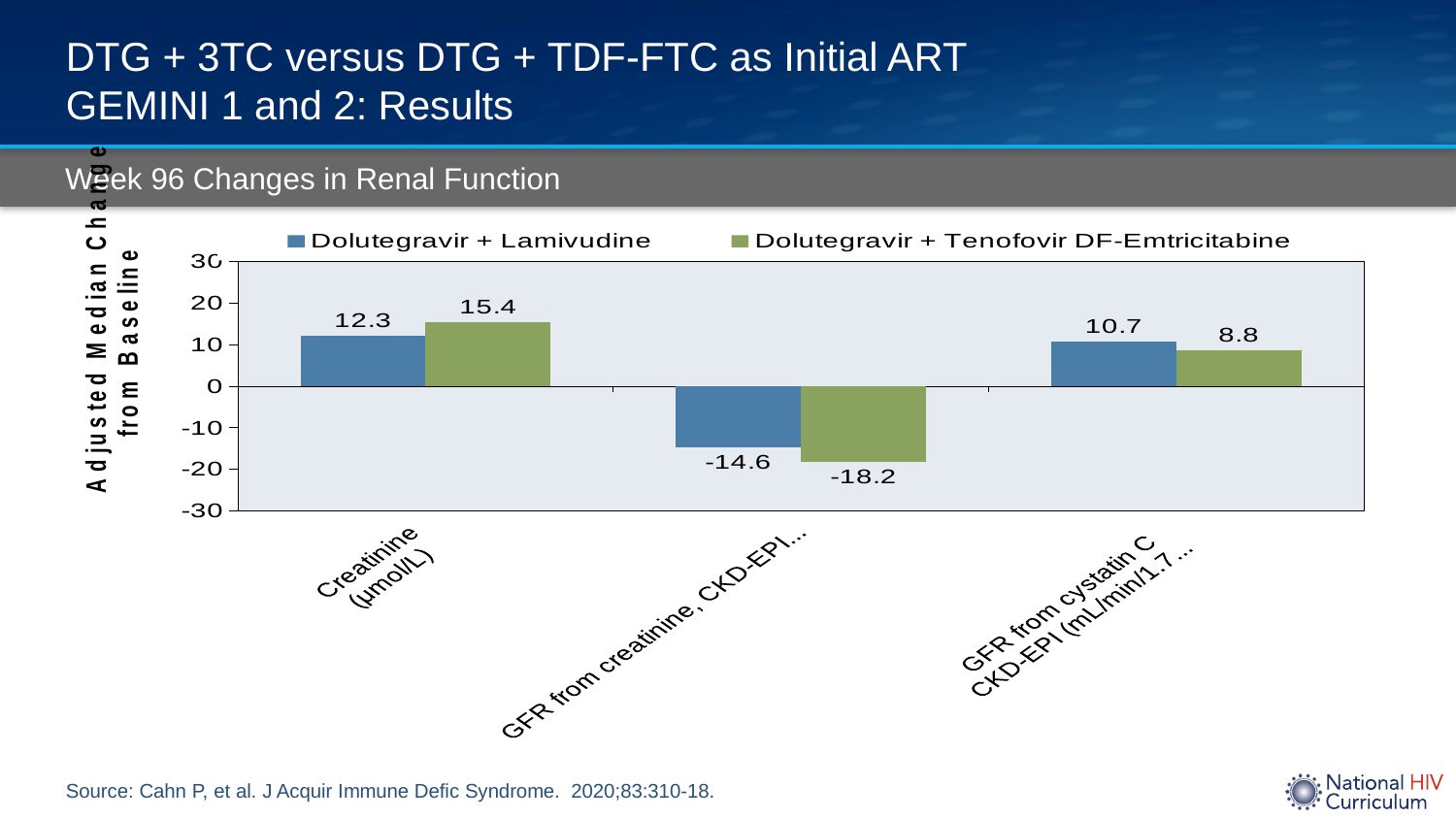
What is the difference between the Dolutegravir + Lamivudine and Dolutegravir + Tenofovir DF-Emtricitabine values for GFR from creatinine, CKD-EPI? 3.6 What is the value for Dolutegravir + Tenofovir DF-Emtricitabine for GFR from cystatin C CKD-EPI? 8.8 Which category has the highest value for Dolutegravir + Lamivudine? Creatinine (µmol/L) For GFR from cystatin C CKD-EPI, which series has the larger value? Dolutegravir + Lamivudine How many categories are shown on the x axis? 3 What is the value for Dolutegravir + Lamivudine for GFR from creatinine, CKD-EPI? -14.6 What is the value for Dolutegravir + Lamivudine for Creatinine (µmol/L)? 12.3 What is the difference between the Dolutegravir + Tenofovir DF-Emtricitabine and Dolutegravir + Lamivudine values for Creatinine (µmol/L)? 3.1 What is the value for Dolutegravir + Tenofovir DF-Emtricitabine for Creatinine (µmol/L)? 15.4 Which category has the lowest value for Dolutegravir + Tenofovir DF-Emtricitabine? GFR from creatinine, CKD-EPI What kind of chart is shown on the slide? Bar chart How many series does the legend list? 2